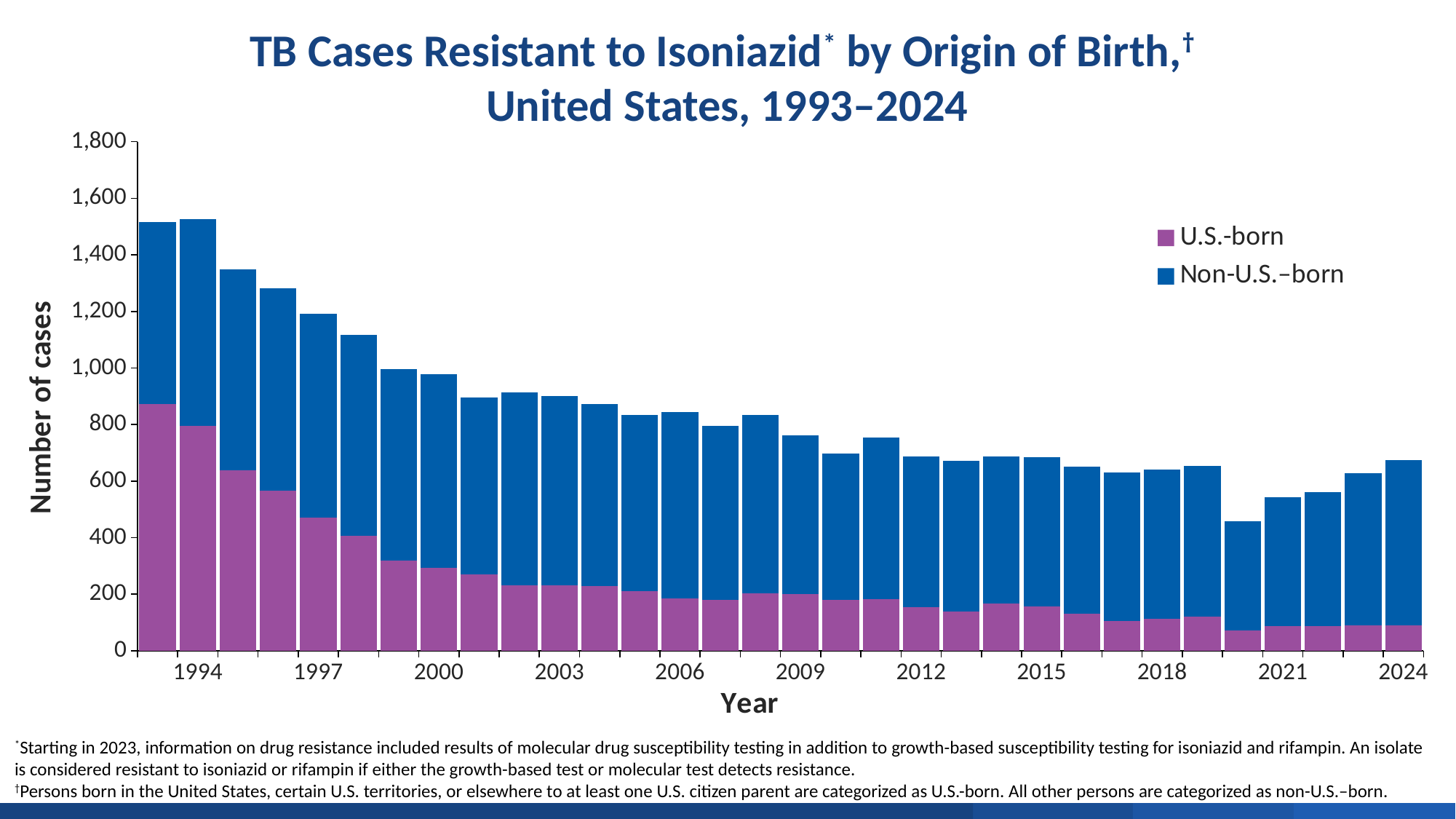
Is the total number of cases in 1993 greater or less than 1,400? greater Is the number of U.S.-born cases in 1993 greater or less than 800? greater How many years (bars) are plotted in the chart? 32 What kind of chart is shown on the slide? Stacked bar chart How many series does the legend list? 2 Which year has the highest number of U.S.-born isoniazid-resistant TB cases? 1993 Which year has the larger total number of cases, 1993 or 2024? 1993 Which colour represents Non-U.S.-born cases in the chart? Blue Is the number of U.S.-born cases in 2024 greater or less than 200? less Which year has the lowest total number of isoniazid-resistant TB cases? 2020 Overall, do total isoniazid-resistant TB cases rise or fall from 1993 to 2020? fall